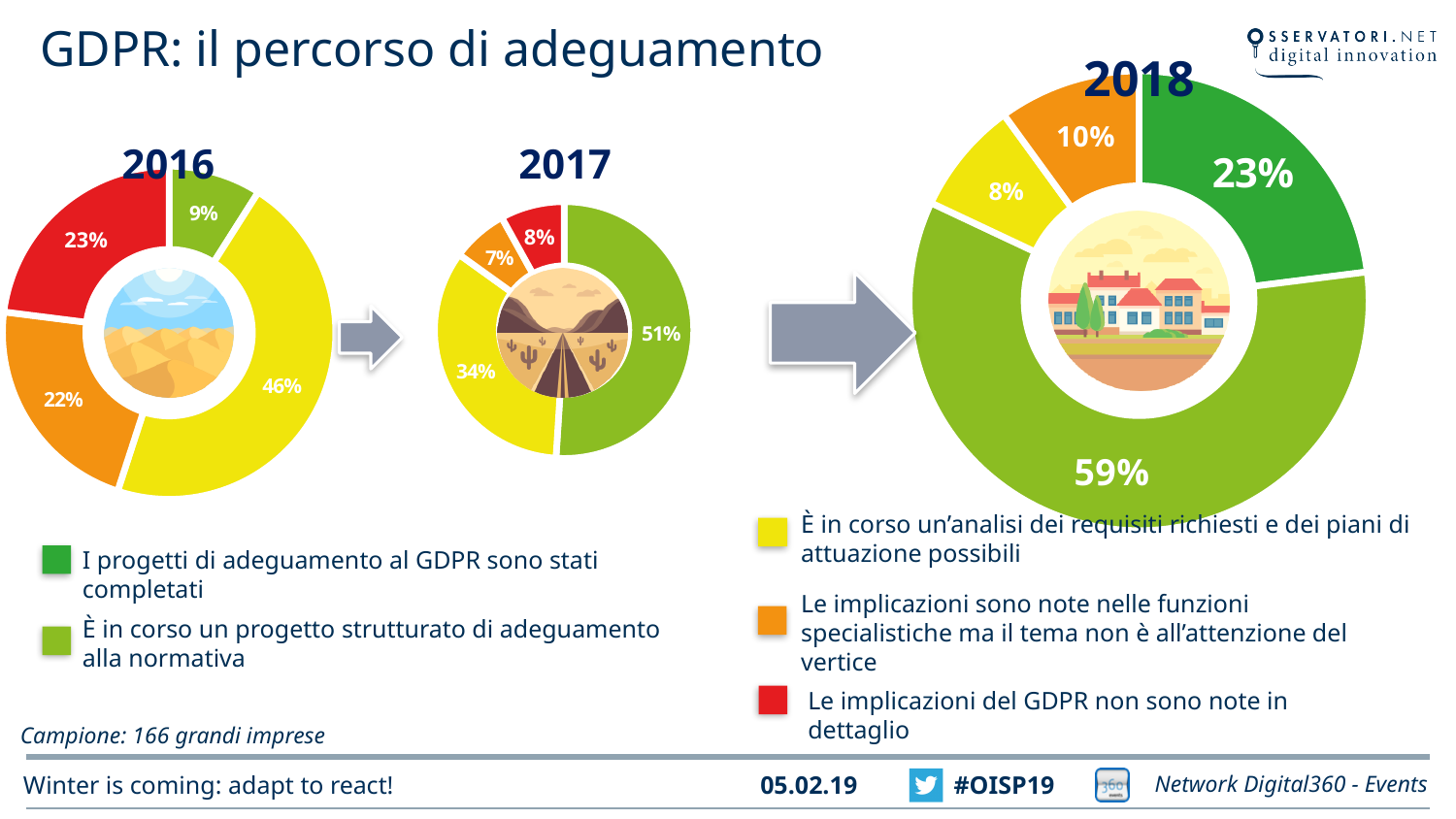
In the 2018 chart, which slice is the largest? 59% In the 2017 chart, what percentage corresponds to a structured adaptation project in progress (light green slice)? 51% In the 2018 chart, what percentage is shown for the orange slice (implications known in specialist functions but not at top management level)? 10% In the 2018 chart, what percentage of companies have completed their GDPR adaptation projects (dark green slice)? 23% How many slices does the 2018 chart have? 4 In the 2017 chart, what percentage is shown for the red slice (GDPR implications not known in detail)? 8% By how many percentage points did the share of completed GDPR projects (dark green) increase from 2016 to 2018? 14 percentage points In the 2016 chart, what percentage of companies had completed their GDPR adaptation projects (dark green slice)? 9% What type of chart is used to show the 2016, 2017 and 2018 data? Donut (pie) chart In the 2017 chart, what is the smallest percentage shown? 7% In the 2016 chart, which is larger: the red slice or the orange slice? The red slice (23%) According to the note on the slide, how many large companies make up the sample? 166 grandi imprese